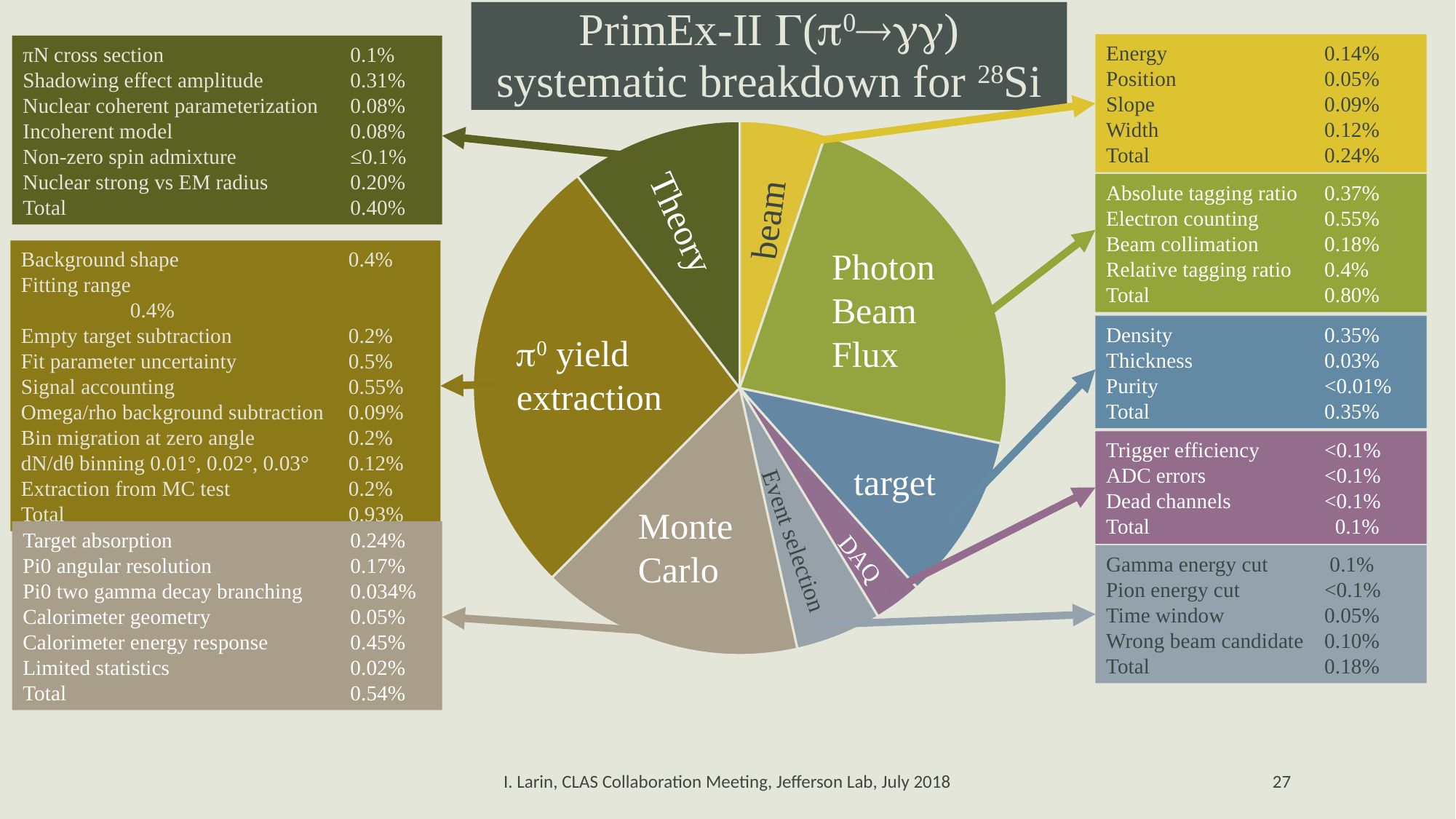
What is the difference between the Photon Beam Flux total (0.80%) and the Theory total (0.40%)? 0.40% According to the box linked to the Monte Carlo slice, what is the total systematic uncertainty for Monte Carlo? 0.54% According to the box linked to the π0 yield extraction slice, what is the total systematic uncertainty for π0 yield extraction? 0.93% Which slice of the pie chart is the largest? π0 yield extraction What is the title of the chart on the slide? PrimEx-II Γ(π0→γγ) systematic breakdown for 28Si How many slices does the pie chart have? 8 Which slice is larger, Monte Carlo or target? Monte Carlo What kind of chart is shown on the slide? pie chart Which slice is larger, Photon Beam Flux or Theory? Photon Beam Flux Which slice of the pie chart is the smallest? DAQ According to the box linked to the Photon Beam Flux slice, what is the total systematic uncertainty for Photon Beam Flux? 0.80% According to the box linked to the target slice, what is the total systematic uncertainty for target? 0.35%